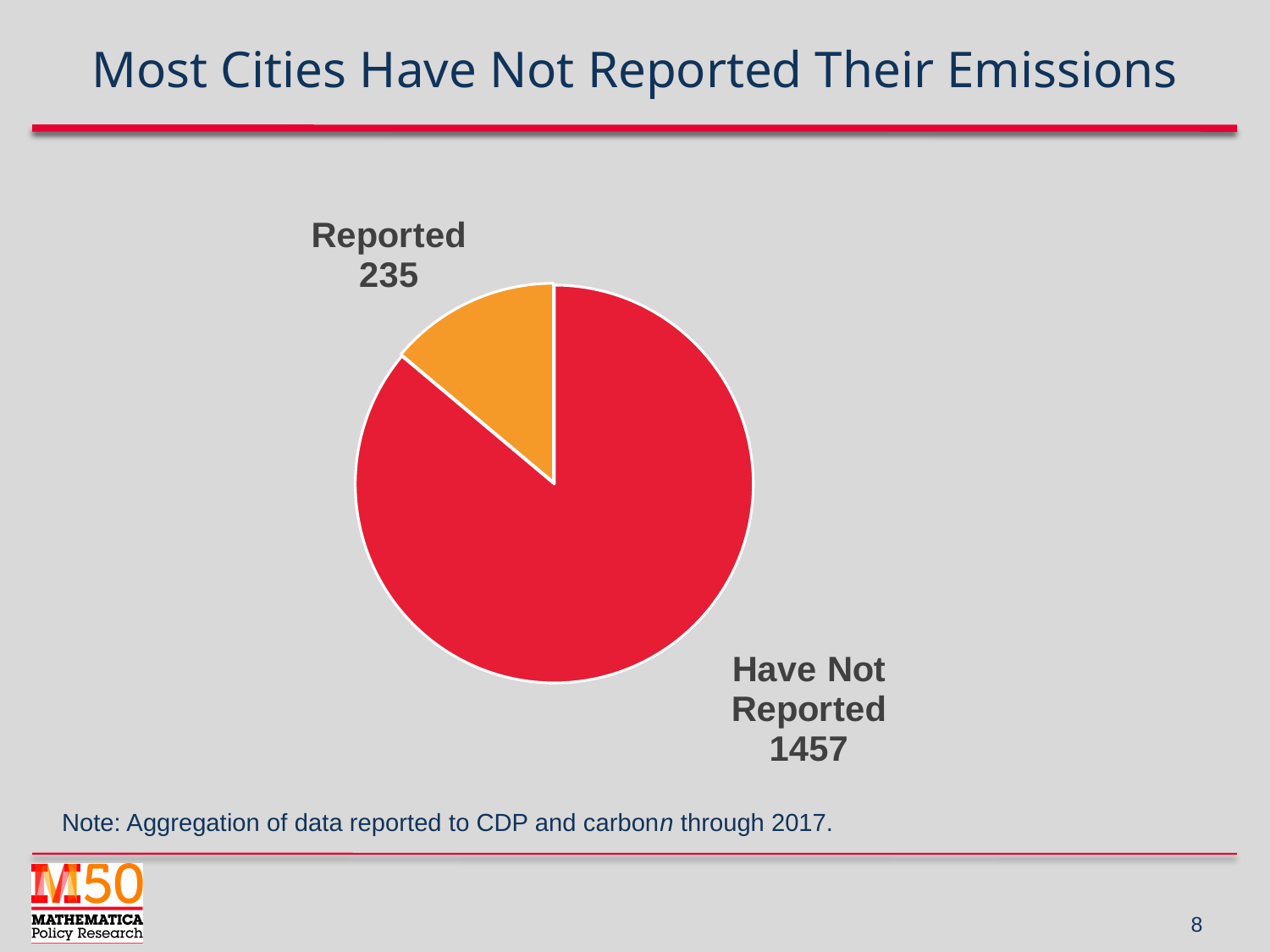
What colour is the Reported slice of the pie chart? orange What is the title of the slide containing the pie chart? Most Cities Have Not Reported Their Emissions How many slices does the pie chart have? 2 Which category has the largest slice in the pie chart? Have Not Reported How many cities have not reported their emissions according to the pie chart? 1457 What is the total number of cities represented in the pie chart? 1692 Which category has the smallest slice in the pie chart? Reported How many cities have reported their emissions according to the pie chart? 235 How many more cities have not reported than have reported? 1222 What kind of chart is shown on the slide? pie chart Which slice of the pie chart is larger, Reported or Have Not Reported? Have Not Reported